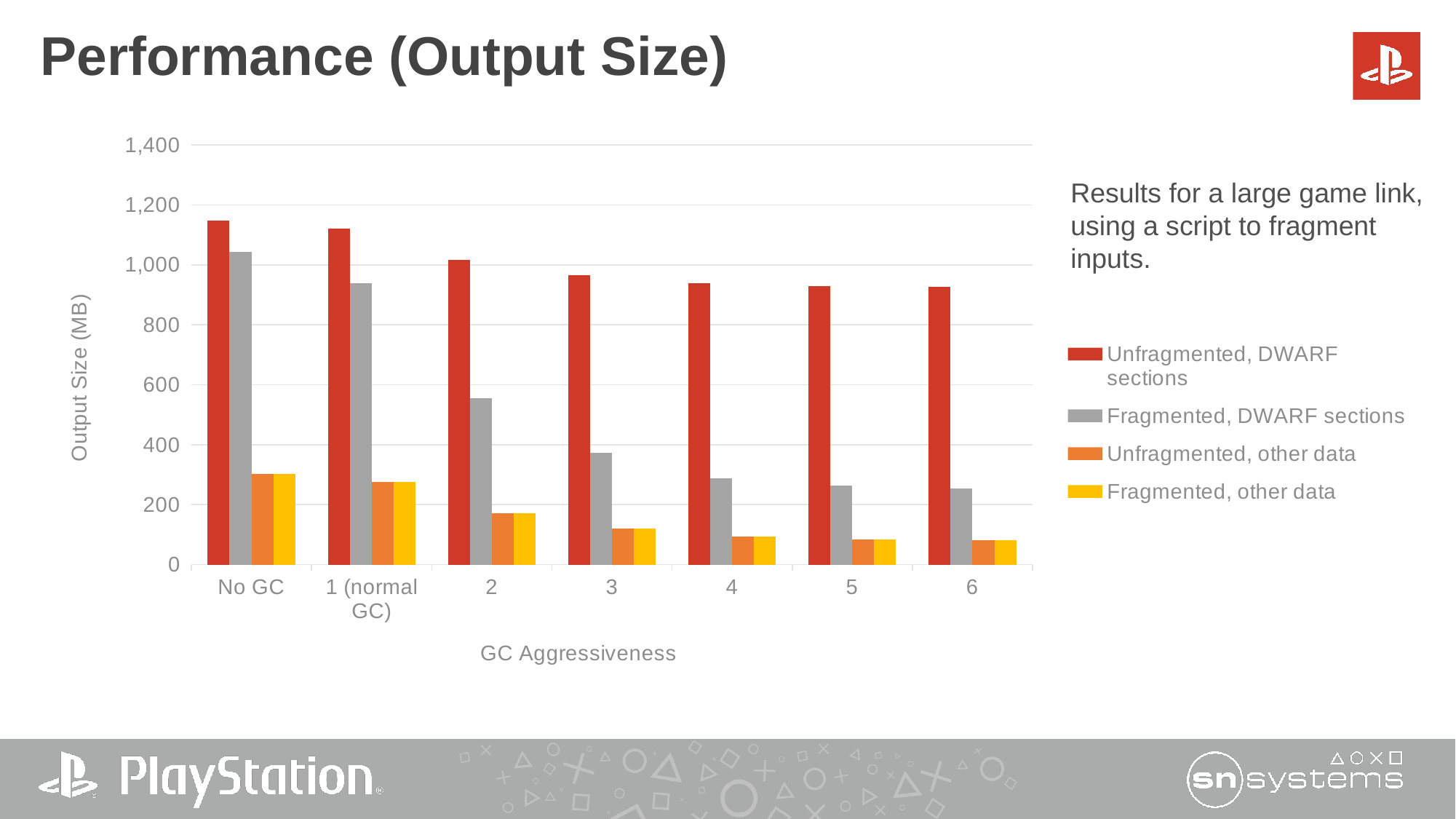
What is the title of the y axis? Output Size (MB) Is the value for Unfragmented, other data at No GC greater or less than 200? greater At GC aggressiveness 2, which is larger: Unfragmented, DWARF sections or Fragmented, DWARF sections? Unfragmented, DWARF sections Is the value for Unfragmented, DWARF sections at GC aggressiveness 6 greater or less than 800? greater Do the values for Fragmented, DWARF sections rise or fall as GC aggressiveness increases along the x axis? fall Is the value for Fragmented, DWARF sections at GC aggressiveness 2 greater or less than 600? less What kind of chart is shown on the slide? Bar chart How many series does the legend list? 4 What is the title of the x axis? GC Aggressiveness How many GC aggressiveness categories are shown on the x axis? 7 Which GC aggressiveness category has the highest value for Fragmented, DWARF sections? No GC